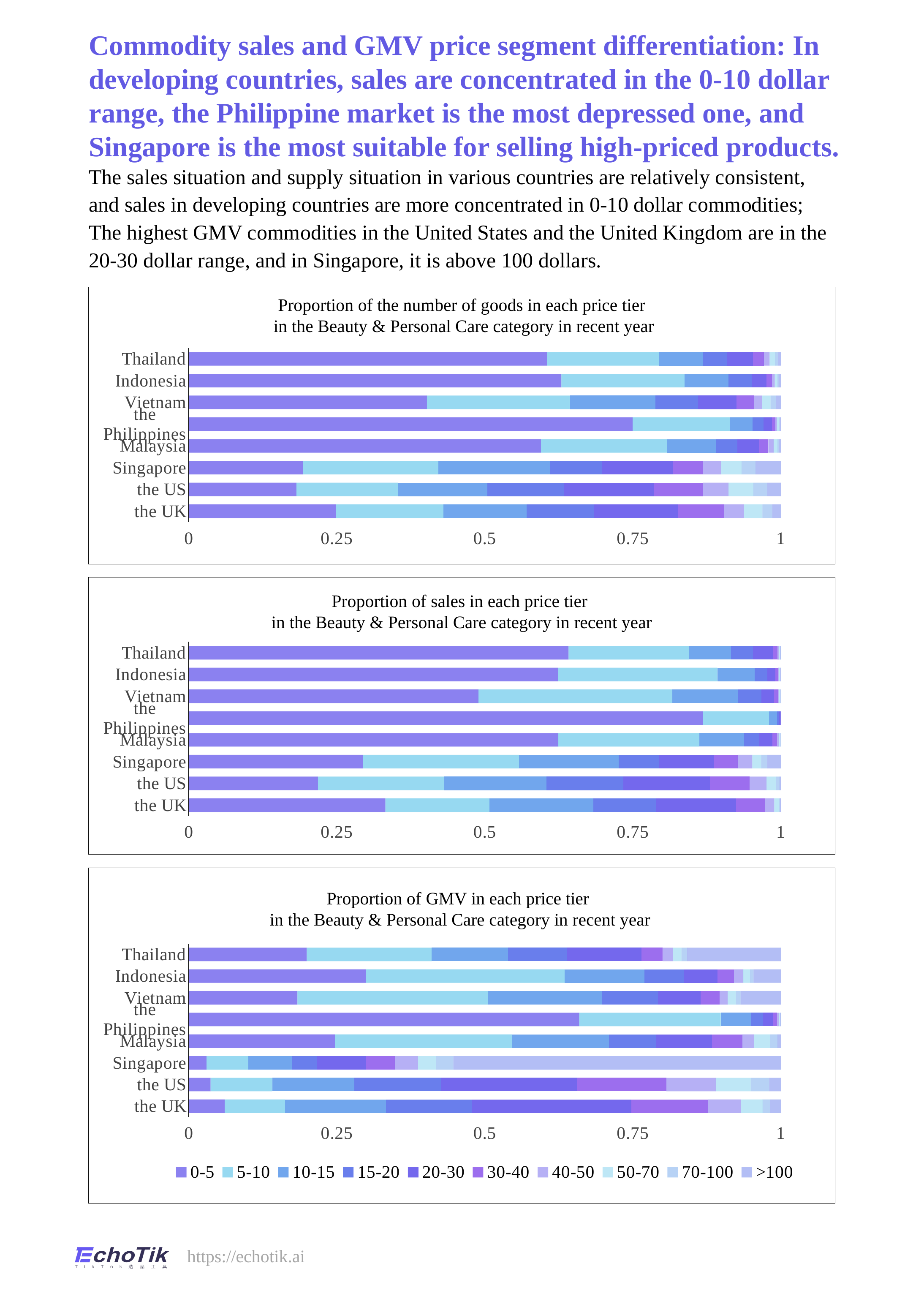
In the top chart, how many countries are shown on the vertical axis? 8 In the top chart, 'Proportion of the number of goods in each price tier', which country has the largest 0-5 segment? the Philippines What kind of chart is the top chart, 'Proportion of the number of goods in each price tier'? stacked bar chart In the middle chart, is the 0-5 segment for the Philippines greater or less than 0.75? greater In the bottom chart, is the 0-5 segment for Singapore greater or less than 0.25? less In the top chart, is the 0-5 segment for Thailand greater or less than 0.5? greater What is the last price tier listed in the legend? >100 How many price tiers does the legend at the bottom of the slide list? 10 In the bottom chart, 'Proportion of GMV in each price tier', which country has the smallest 0-5 segment? Singapore In the middle chart, 'Proportion of sales in each price tier', which country has the largest 0-5 segment? the Philippines In the bottom chart, which country has the larger 0-5 segment, the Philippines or the UK? the Philippines In the top chart, which country has the larger 0-5 segment, Thailand or Singapore? Thailand